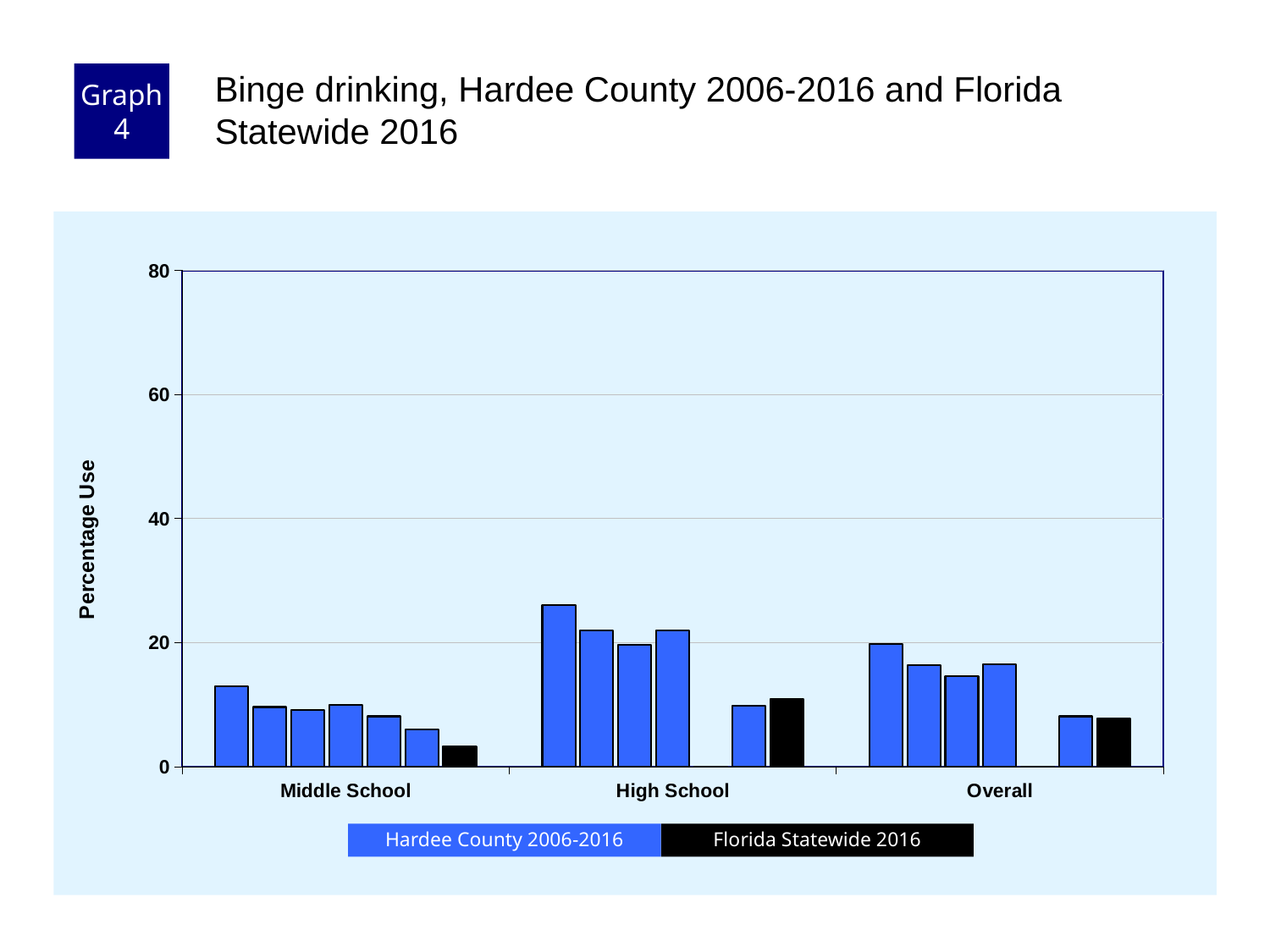
Is the Florida Statewide 2016 value for Middle School greater or less than 20? less In the Middle School group, which is larger: the leftmost Hardee County bar or the Florida Statewide 2016 bar? the leftmost Hardee County bar Which category contains the tallest bar on the chart? High School What is the title of the y axis? Percentage Use Is the tallest Hardee County bar in the Middle School group greater or less than 20? less Which category has the lowest Florida Statewide 2016 value? Middle School How many categories are shown along the x axis? 3 What kind of chart is shown on the slide? bar chart How many series does the legend list? 2 What colour are the Florida Statewide 2016 bars? black Is the Florida Statewide 2016 value for Overall greater or less than 20? less